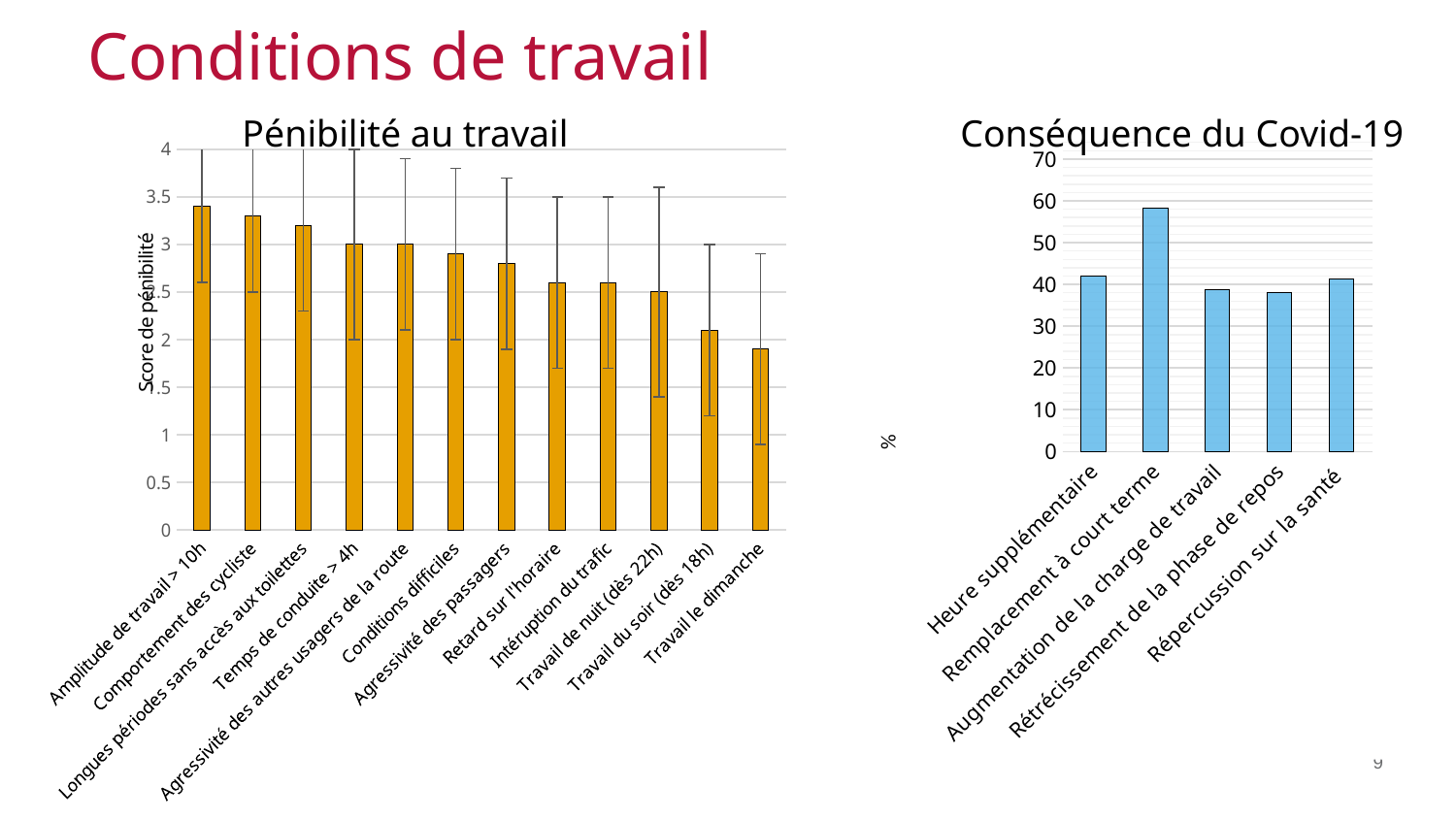
In the 'Pénibilité au travail' chart, is the value for 'Conditions difficiles' greater or less than 3? less In the 'Conséquence du Covid-19' chart, which is larger: the value for 'Heure supplémentaire' or the value for 'Rétrécissement de la phase de repos'? Heure supplémentaire What is the y-axis label of the 'Pénibilité au travail' chart? Score de pénibilité In the 'Conséquence du Covid-19' chart, which category has the highest value? Remplacement à court terme In the 'Pénibilité au travail' chart, is the value for 'Travail le dimanche' greater or less than 2? less What kind of chart is the 'Pénibilité au travail' chart? bar chart In the 'Pénibilité au travail' chart, which category has the lowest score? Travail le dimanche In the 'Pénibilité au travail' chart, which is larger: the value for 'Comportement des cycliste' or the value for 'Travail du soir (dès 18h)'? Comportement des cycliste How many categories are shown in the 'Conséquence du Covid-19' chart? 5 How many categories are shown in the 'Pénibilité au travail' chart? 12 In the 'Conséquence du Covid-19' chart, is the value for 'Remplacement à court terme' greater or less than 50? greater